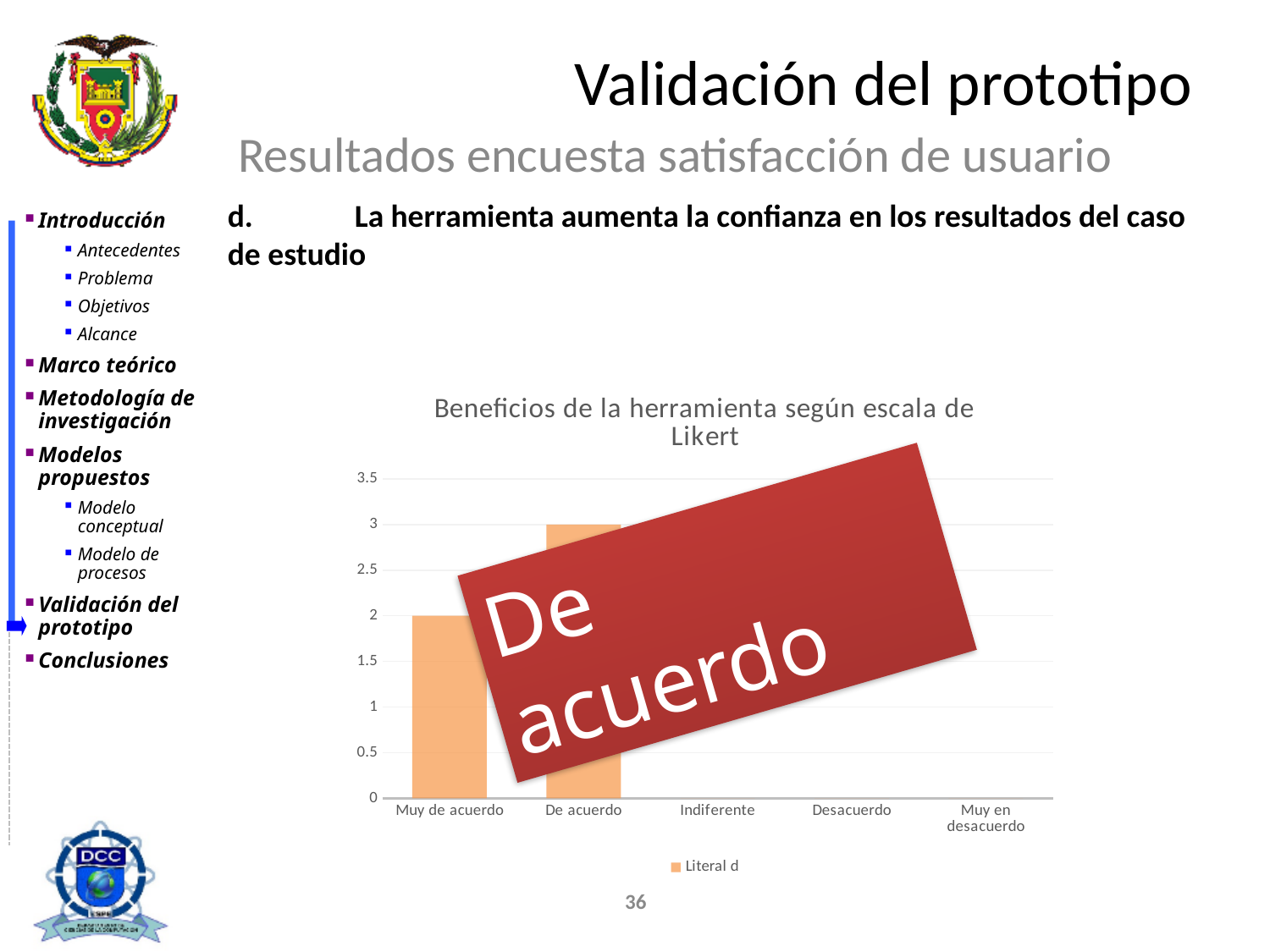
What kind of chart is shown on the slide? bar chart What is the difference between the value for 'De acuerdo' and the value for 'Muy de acuerdo'? 1 What is the value for 'Muy de acuerdo' in the chart? 2 What is the title of the chart? Beneficios de la herramienta según escala de Likert Which is larger, the value for 'De acuerdo' or the value for 'Muy de acuerdo'? De acuerdo What is the value for 'De acuerdo' in the chart? 3 Is the value for 'Muy de acuerdo' greater or less than 2.5? less How many series does the chart legend list? 1 Is the value for 'De acuerdo' greater or less than 2.5? greater How many categories are shown on the x axis of the chart? 5 Which category has the highest value in the chart? De acuerdo What is the name of the series shown in the chart legend? Literal d